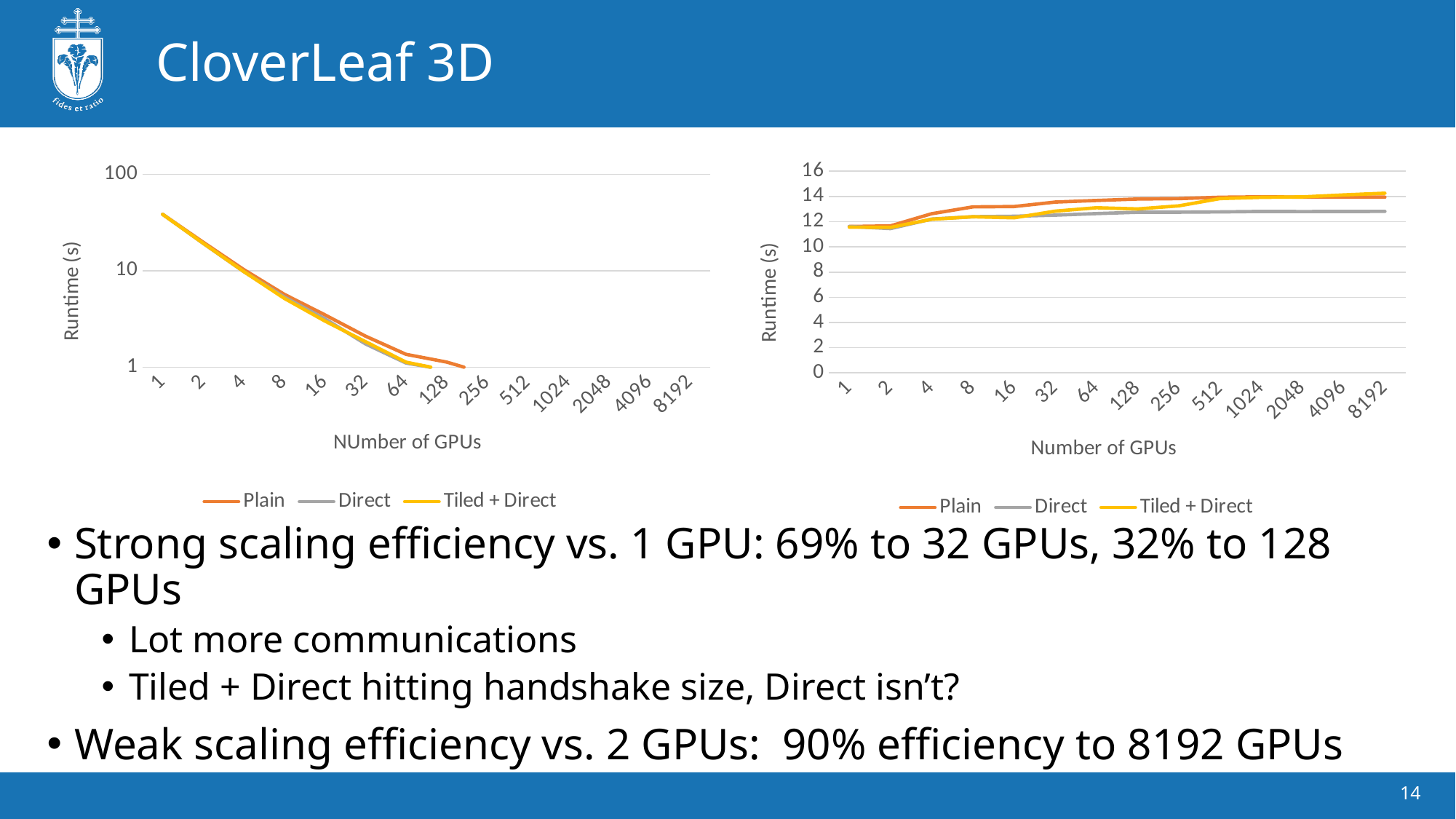
How many GPU counts are labelled on the x axis of the right chart? 14 In the right chart, is the runtime for Direct at 8192 GPUs greater or less than 14? less How many series does the legend of the left chart list? 3 How many series does the legend of the right chart list? 3 In the right chart, do the runtime values rise or fall as the number of GPUs increases? rise What kind of chart is the left chart? line chart What is the x-axis title of the right chart? Number of GPUs What kind of chart is the right chart? line chart In the left chart, is the runtime for Plain at 64 GPUs greater or less than 10? less In the left chart, is the runtime for Plain at 1 GPU greater or less than 10? greater In the right chart, which series has the lowest runtime at 8192 GPUs? Direct In the left chart, do the runtime values rise or fall as the number of GPUs increases? fall